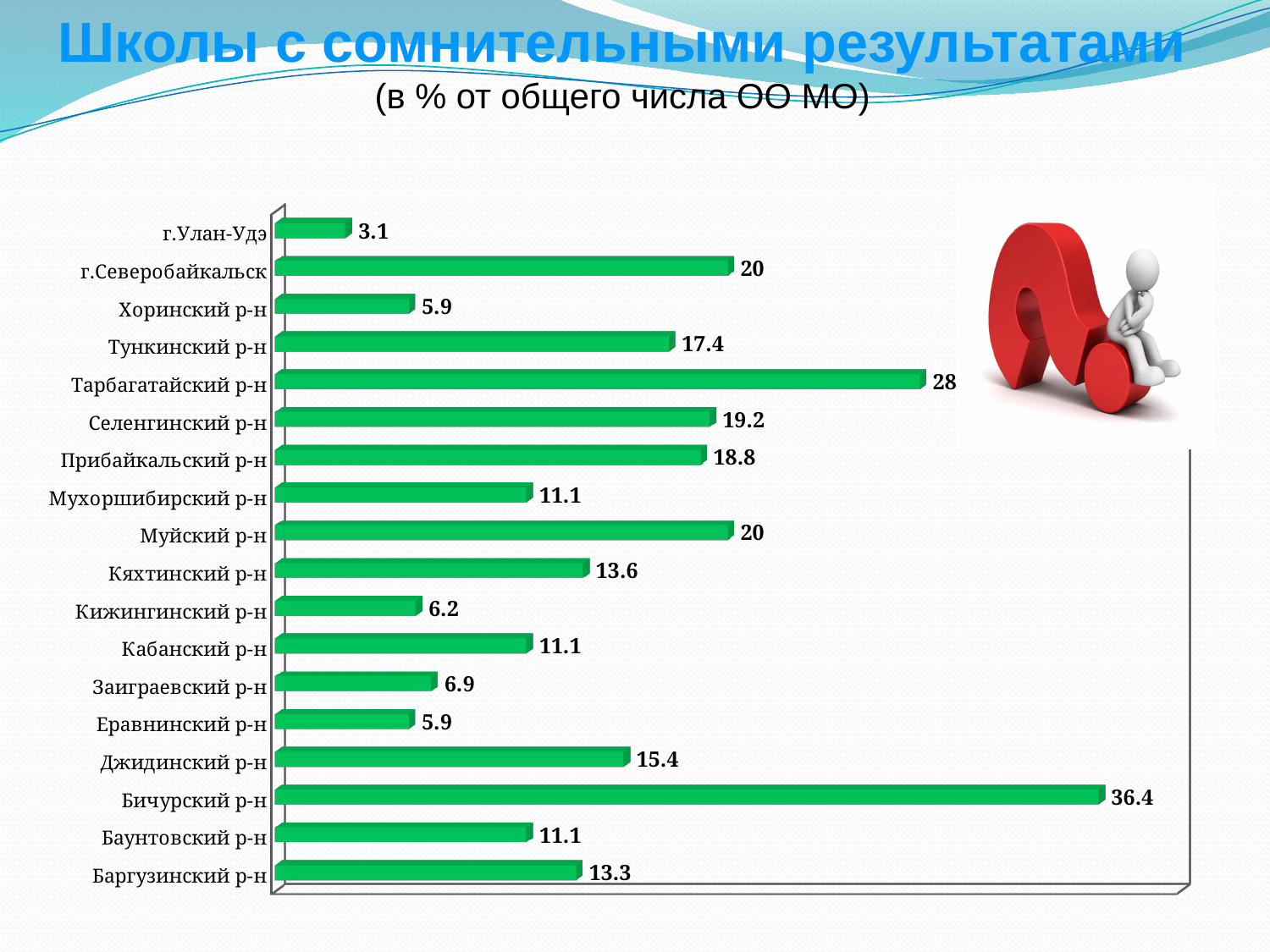
Which category has the highest value? Бичурский р-н Which is larger, the value for Тункинский р-н or the value for Кяхтинский р-н? Тункинский р-н What is the value for Тарбагатайский р-н? 28 How many categories are shown in the chart? 18 What is the title of the chart on the slide? Школы с сомнительными результатами Which category has the lowest value? г.Улан-Удэ What is the difference between the values for Бичурский р-н and Тарбагатайский р-н? 8.4 What is the difference between the values for г.Северобайкальск and г.Улан-Удэ? 16.9 What is the value for Джидинский р-н? 15.4 What kind of chart is shown on the slide? Bar chart What is the value for Бичурский р-н? 36.4 What is the value for г.Улан-Удэ? 3.1